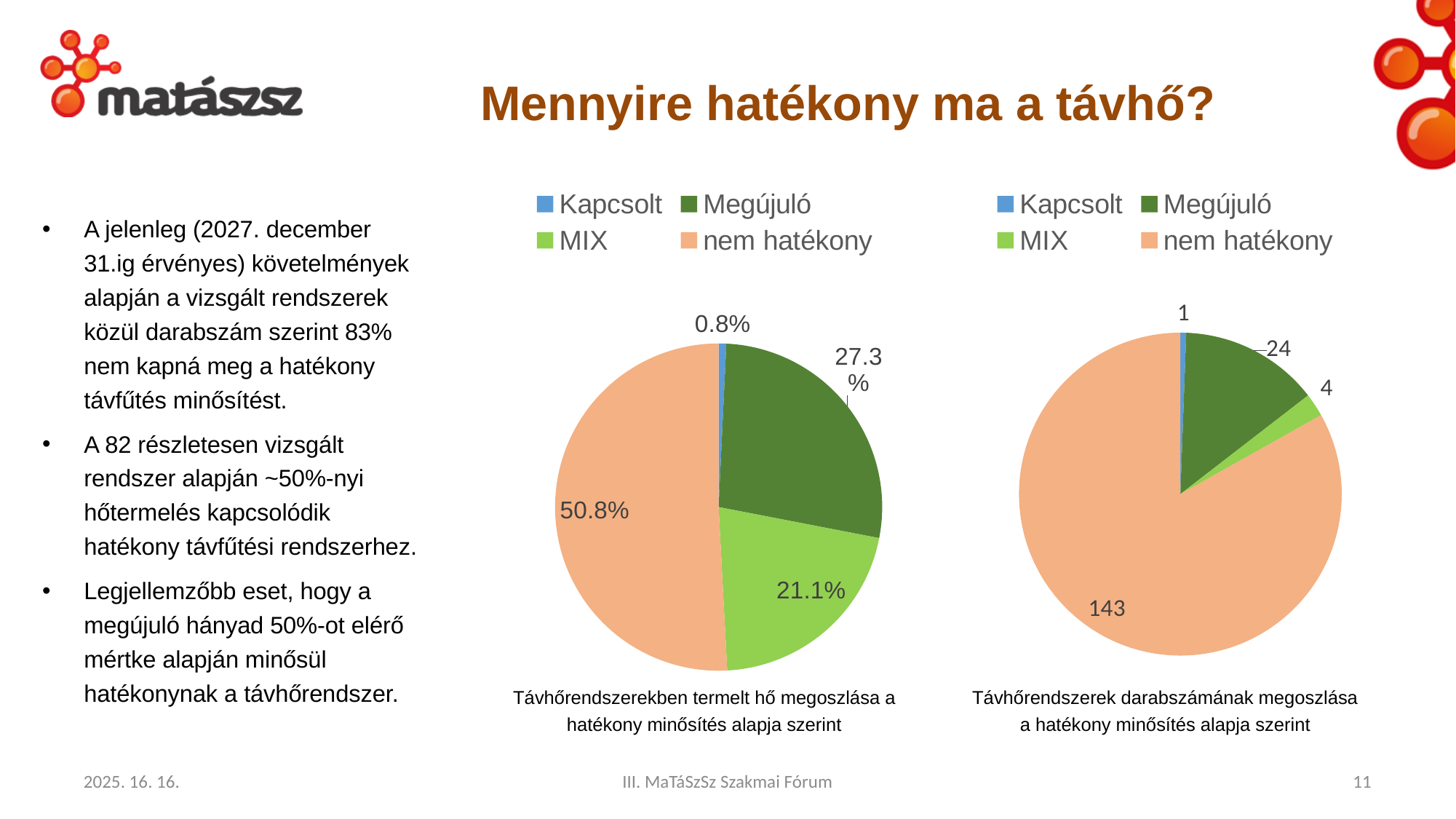
In the right pie chart (Távhőrendszerek darabszámának megoszlása), which category has the smallest value? Kapcsolt In the left pie chart (Távhőrendszerekben termelt hő megoszlása), what is the value for nem hatékony? 50.8% In the right pie chart (Távhőrendszerek darabszámának megoszlása), what is the total of all four categories? 172 In the right pie chart (Távhőrendszerek darabszámának megoszlása), which is larger, Megújuló or MIX? Megújuló In the left pie chart (Távhőrendszerekben termelt hő megoszlása), which category has the largest share? nem hatékony In the left pie chart (Távhőrendszerekben termelt hő megoszlása), what is the difference between Megújuló and MIX? 6.2% How many series does the legend of the left pie chart list? 4 In the left pie chart (Távhőrendszerekben termelt hő megoszlása), what is the value for Kapcsolt? 0.8% In the right pie chart (Távhőrendszerek darabszámának megoszlása), what is the value for nem hatékony? 143 In the right pie chart (Távhőrendszerek darabszámának megoszlása), what is the value for MIX? 4 In the right pie chart (Távhőrendszerek darabszámának megoszlása), what is the difference between nem hatékony and Megújuló? 119 In the left pie chart (Távhőrendszerekben termelt hő megoszlása), what is the value for Megújuló? 27.3%